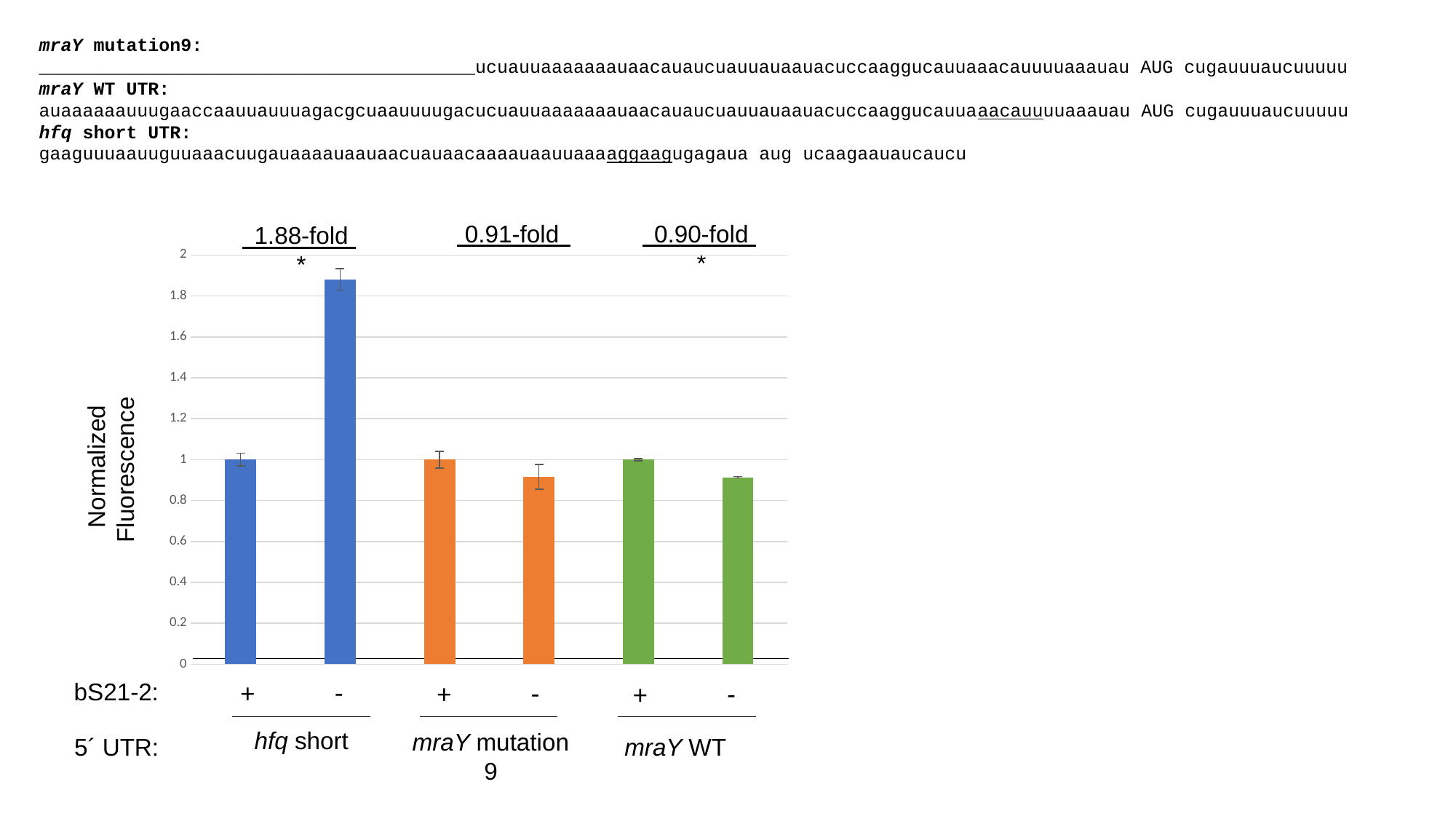
What fold change is annotated above the hfq short group in the chart? 1.88-fold What kind of chart is shown on the slide? bar chart How many bars are plotted in the chart? 6 What colour are the bars for the mraY WT group in the chart? green Is the value for the mraY WT bS21-2 - bar greater or less than 1? less What fold change is annotated above the mraY WT group in the chart? 0.90-fold What is the label of the y axis of the chart? Normalized Fluorescence Which bar is the highest in the chart? hfq short, bS21-2 - How many 5′ UTR groups are shown along the x axis of the chart? 3 Which is larger in the chart: the hfq short bS21-2 - bar or the mraY mutation 9 bS21-2 - bar? hfq short bS21-2 - Is the value for the hfq short bS21-2 - bar greater or less than 1.6? greater What fold change is annotated above the mraY mutation 9 group in the chart? 0.91-fold